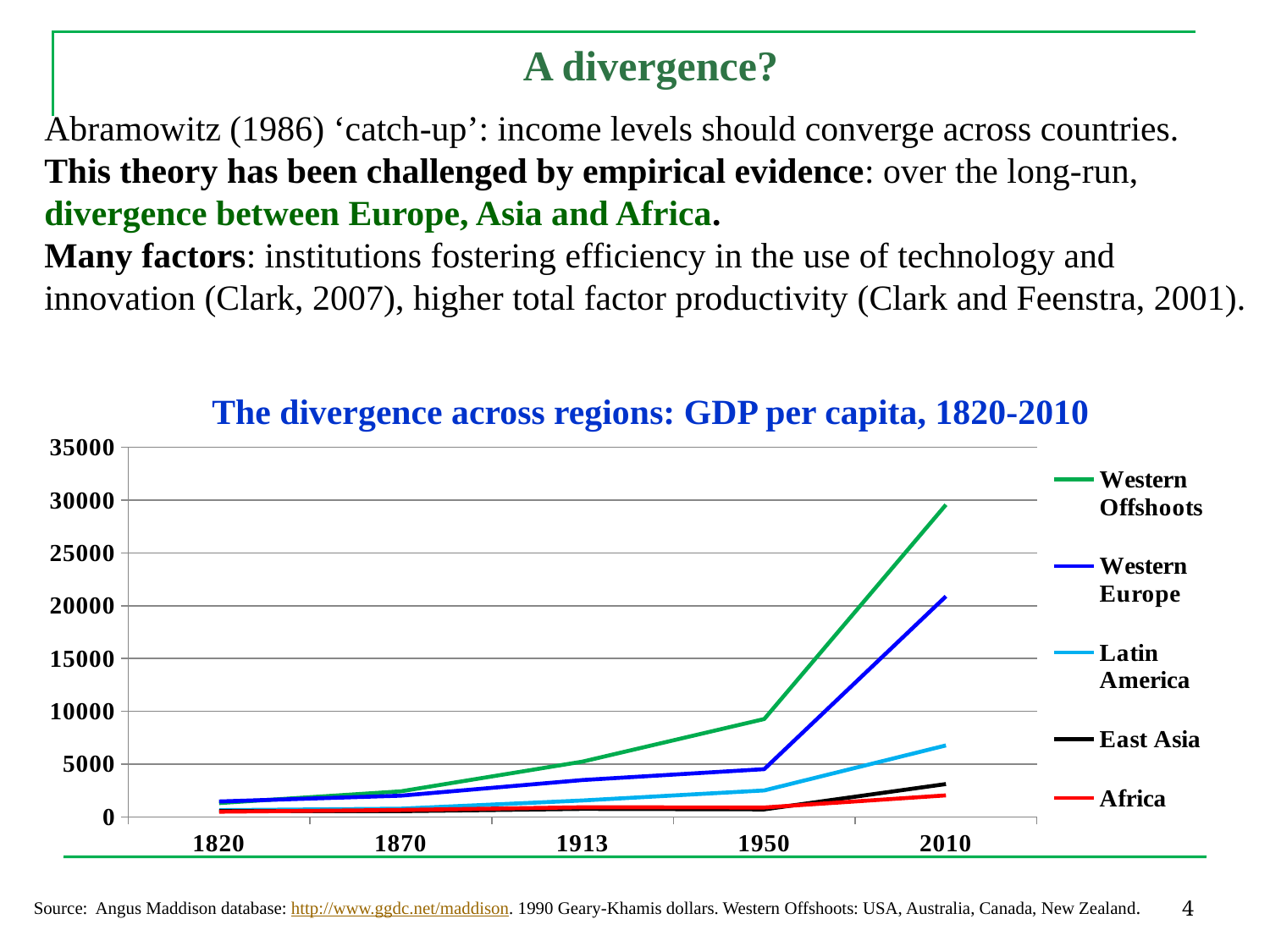
Does the Western Offshoots line rise or fall from 1820 to 2010? rise Is the value for Africa in 2010 greater or less than 5000? less How many years are marked on the x axis? 5 Which region has the lowest GDP per capita in 2010? Africa How many series does the legend list? 5 In 2010, which is larger: the value for Western Europe or the value for Latin America? Western Europe Is the value for Western Europe in 2010 greater or less than 15000? greater Is the value for Western Offshoots in 2010 greater or less than 25000? greater Which colour is used for the East Asia line? black Which region has the highest GDP per capita in 2010? Western Offshoots What is the title of the chart? The divergence across regions: GDP per capita, 1820-2010 What kind of chart is shown on the slide? line chart